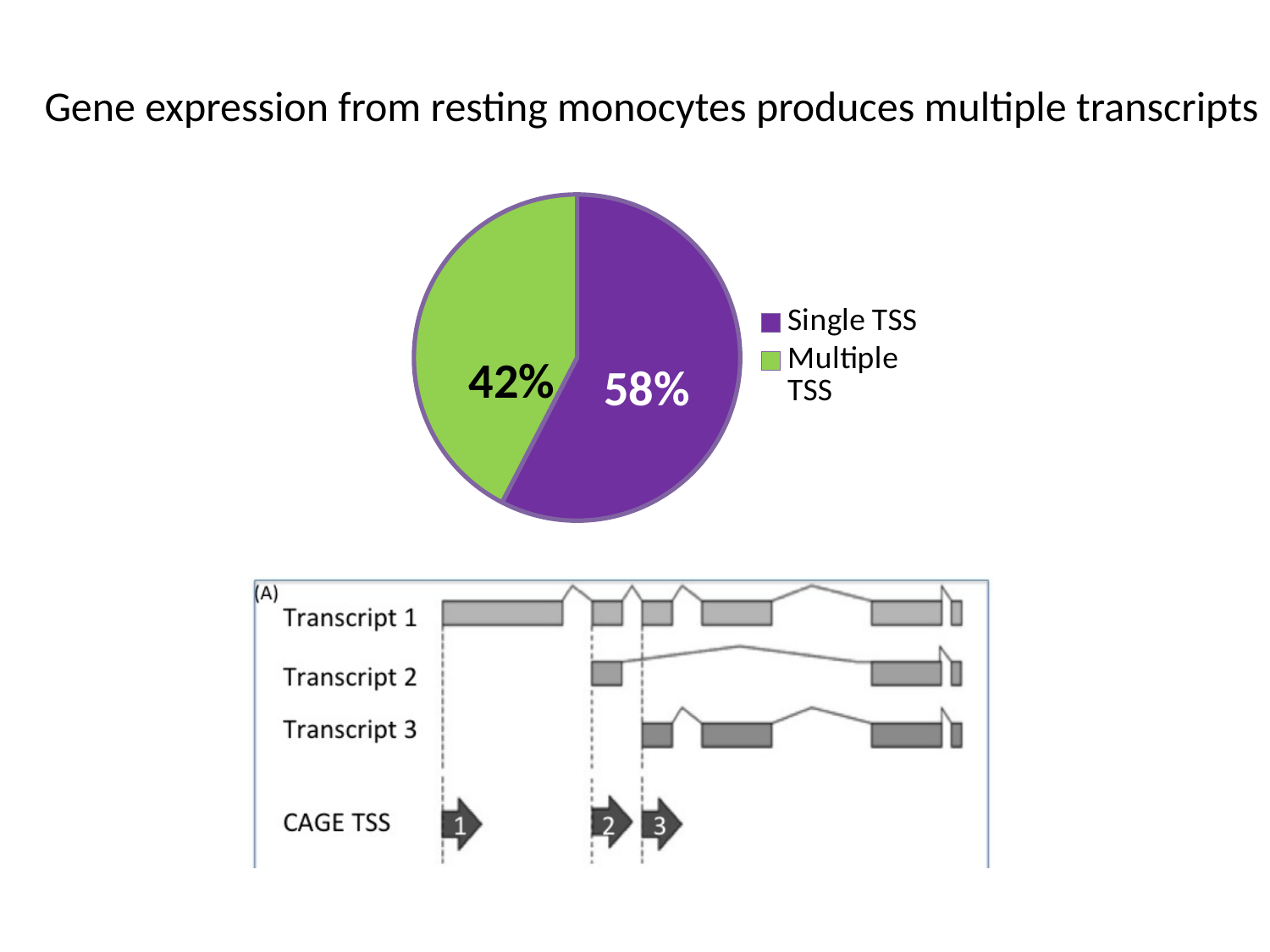
Is the Multiple TSS share of the pie chart greater or less than 50%? less Which slice of the pie chart is the largest? Single TSS What colour is the Multiple TSS slice in the pie chart? green What colour is the Single TSS slice in the pie chart? purple Which is larger in the pie chart, Single TSS or Multiple TSS? Single TSS What is the difference in percentage points between the Single TSS and Multiple TSS slices? 16 What percentage of the pie chart is Single TSS? 58% Which slice of the pie chart is the smallest? Multiple TSS What percentage of the pie chart is Multiple TSS? 42% What kind of chart is shown on the slide? pie chart How many slices does the pie chart have? 2 How many entries does the pie chart legend list? 2